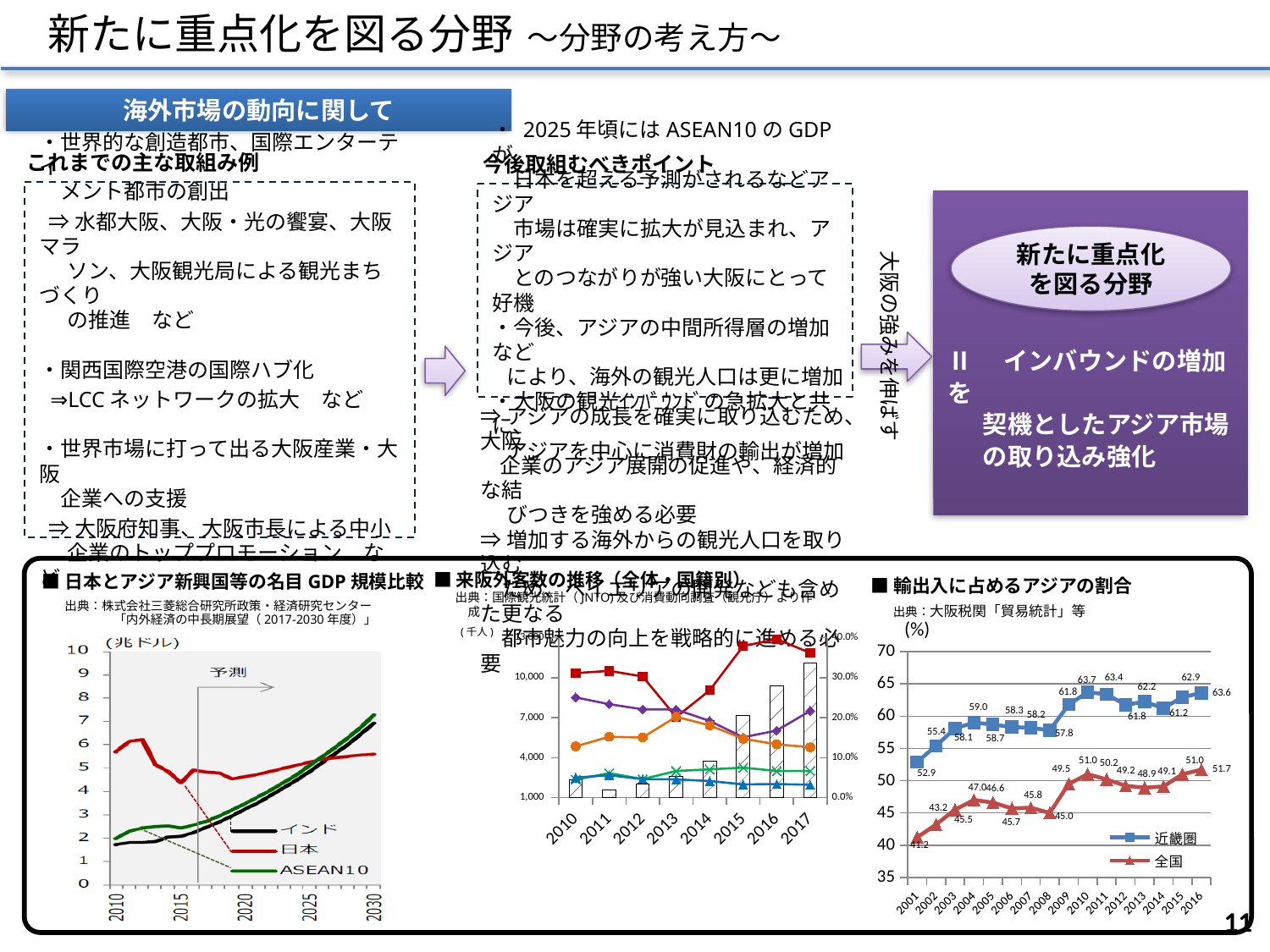
In the chart titled 輸出入に占めるアジアの割合, what is the value for 全国 in 2001? 41.2 In the chart titled 輸出入に占めるアジアの割合, does the 全国 value overall rise or fall from 2001 to 2016? Rise In the chart titled 日本とアジア新興国等の名目GDP規模比較, which series has the highest value in 2010? 日本 In the chart titled 輸出入に占めるアジアの割合, which series has the larger value in 2004, 近畿圏 or 全国? 近畿圏 How many series does the legend of the chart titled 日本とアジア新興国等の名目GDP規模比較 list? 3 How many series does the legend of the chart titled 輸出入に占めるアジアの割合 list? 2 In the chart titled 輸出入に占めるアジアの割合, what is the difference between the 近畿圏 and 全国 values in 2016? 11.9 In the chart titled 輸出入に占めるアジアの割合, in which year is the 全国 value lowest? 2001 In the chart titled 日本とアジア新興国等の名目GDP規模比較, is the value for 日本 in 2010 greater or less than 5? greater What kind of chart is the chart titled 輸出入に占めるアジアの割合? Line chart In the chart titled 輸出入に占めるアジアの割合, what is the value for 近畿圏 in 2016? 63.6 How many years are shown on the x axis of the chart titled 来阪外客数の推移（全体・国籍別）? 8